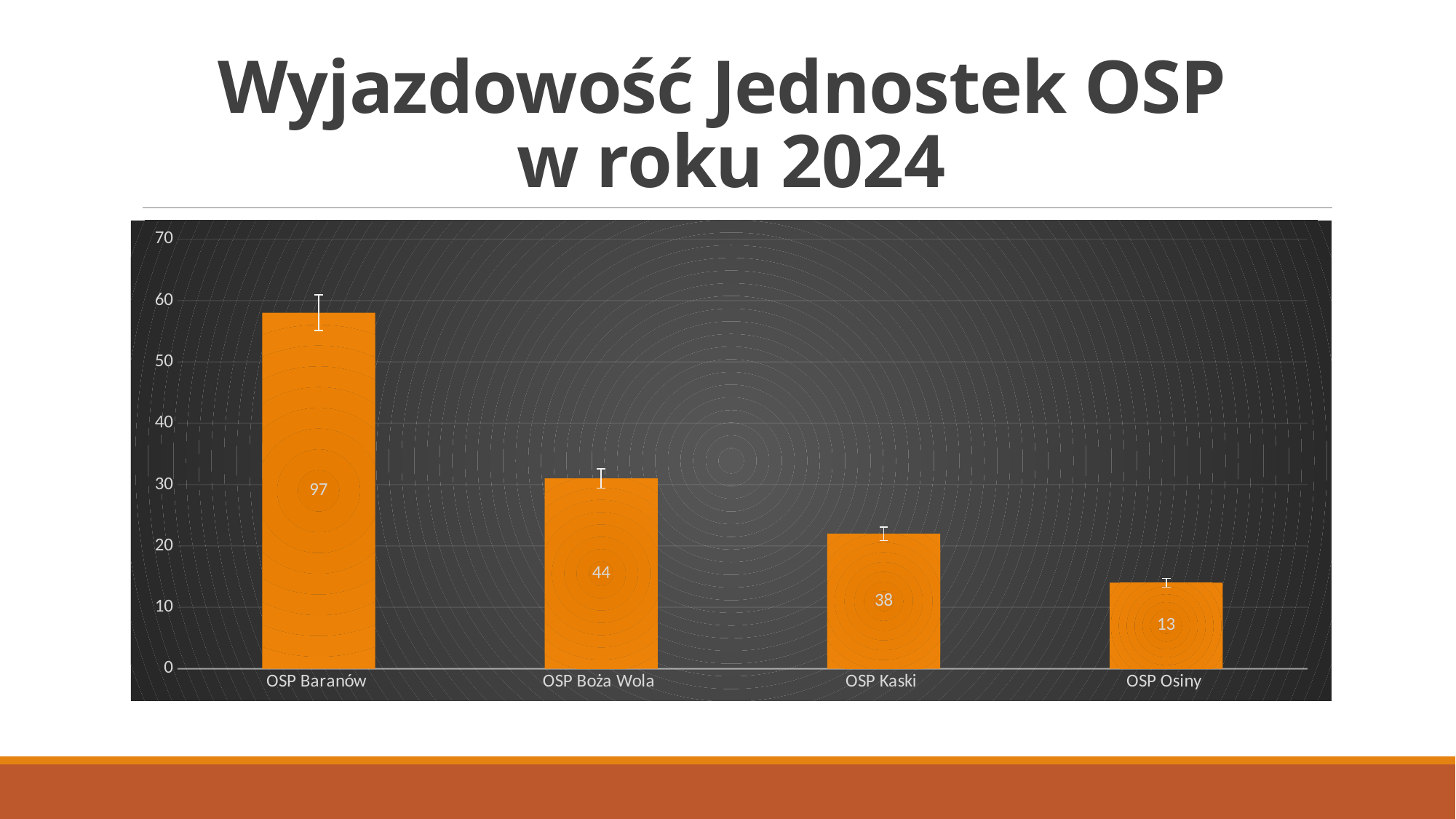
What is the difference between the values for OSP Baranów and OSP Boża Wola? 53 What is the value shown for OSP Baranów? 97 What is the value shown for OSP Boża Wola? 44 What is the value shown for OSP Osiny? 13 Which is larger, the value for OSP Boża Wola or the value for OSP Kaski? OSP Boża Wola What kind of chart is shown on the slide? Bar chart Which unit has the lowest value? OSP Osiny What is the difference between the values for OSP Kaski and OSP Osiny? 25 What is the value shown for OSP Kaski? 38 Do the values rise or fall from left to right across the chart? Fall Which unit has the highest value? OSP Baranów How many units are shown on the chart? 4